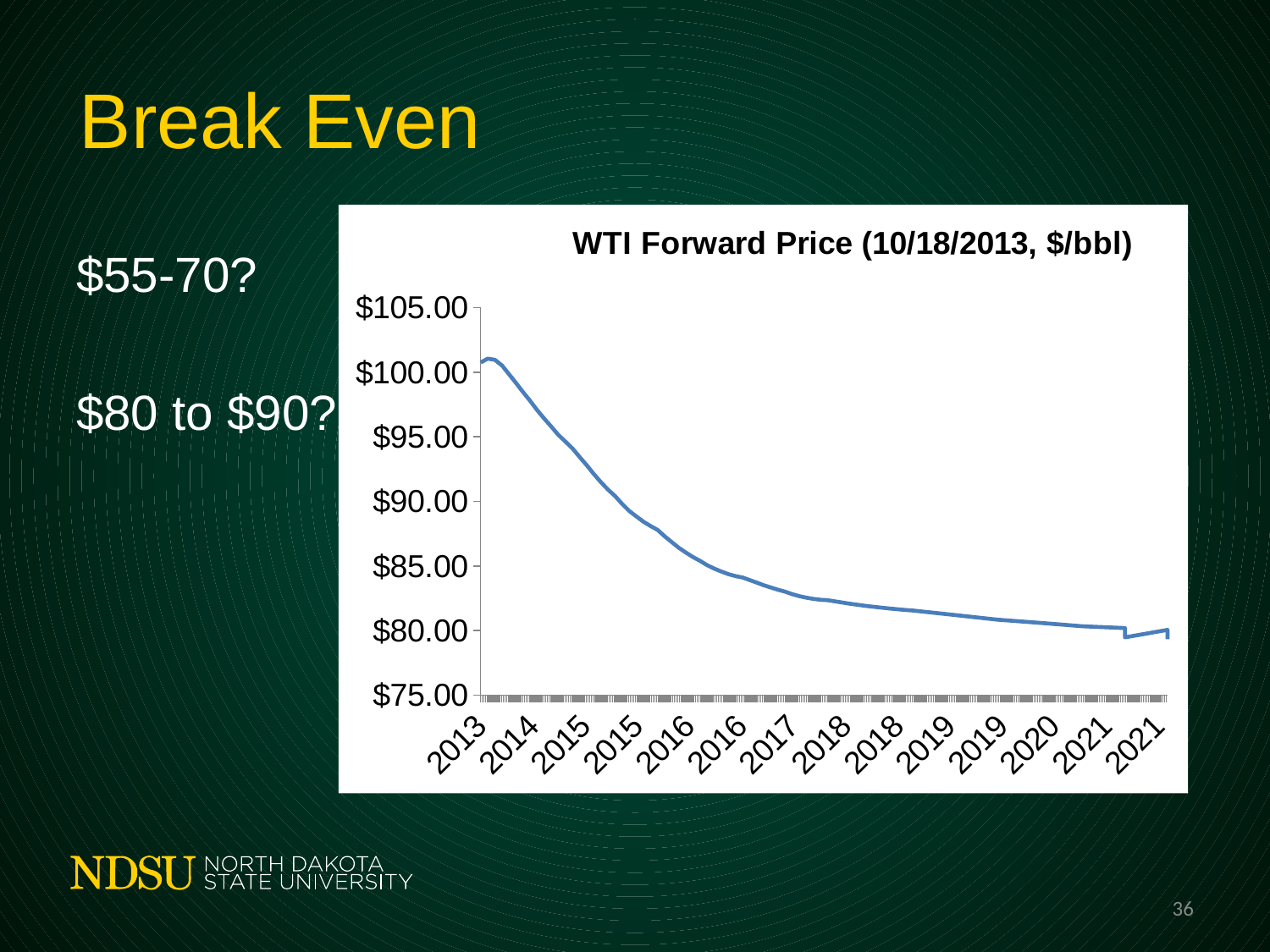
What is the title of the chart? WTI Forward Price (10/18/2013, $/bbl) What is the highest value shown on the y axis of the chart? $105.00 Is the WTI forward price in 2017 greater or less than $90.00? less In which year on the x axis is the WTI forward price highest? 2013 Is the WTI forward price in 2021 greater or less than $85.00? less Which is larger, the WTI forward price in 2015 or in 2018? 2015 Which is larger, the WTI forward price in 2013 or in 2021? 2013 What kind of chart is shown on the slide? line chart Is the WTI forward price at the start of 2013 greater or less than $95.00? greater In which year on the x axis is the WTI forward price lowest? 2021 Does the WTI forward price rise or fall as the years move from 2013 to 2021? fall